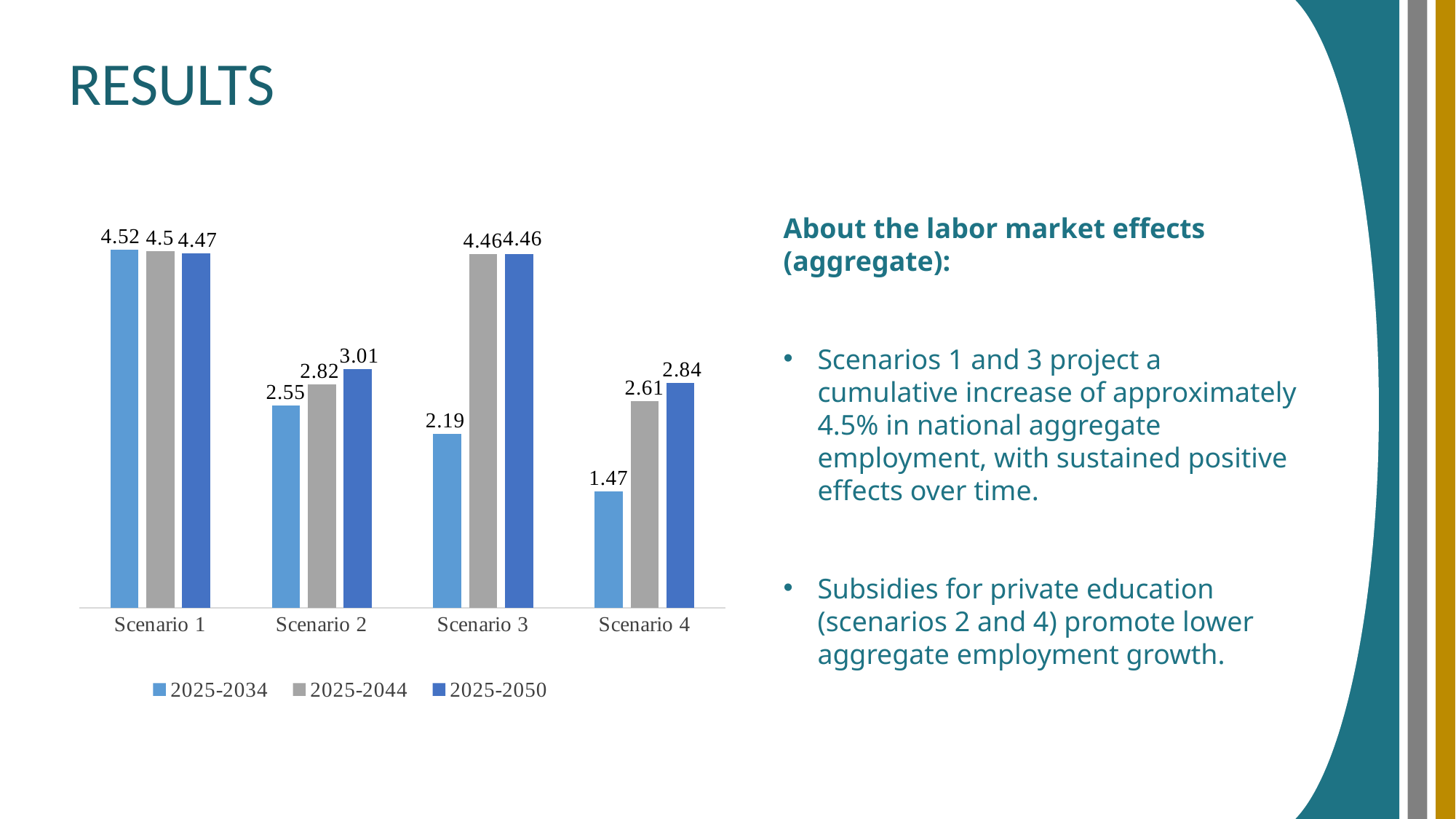
Which is larger: the 2025-2050 value for Scenario 2 or the 2025-2050 value for Scenario 4? Scenario 2 What is the difference between the 2025-2050 and 2025-2034 values for Scenario 3? 2.27 What is the value for Scenario 1 in the 2025-2034 series? 4.52 What is the value for Scenario 4 in the 2025-2050 series? 2.84 What is the value for Scenario 3 in the 2025-2044 series? 4.46 Which scenario has the lowest value in the 2025-2034 series? Scenario 4 Which scenario has the highest value in the 2025-2050 series? Scenario 1 How many series does the chart legend list? 3 How many scenarios are shown on the x axis of the chart? 4 What is the difference between the 2025-2044 values for Scenario 2 and Scenario 4? 0.21 What is the value for Scenario 2 in the 2025-2034 series? 2.55 What kind of chart is shown on the slide? Bar chart